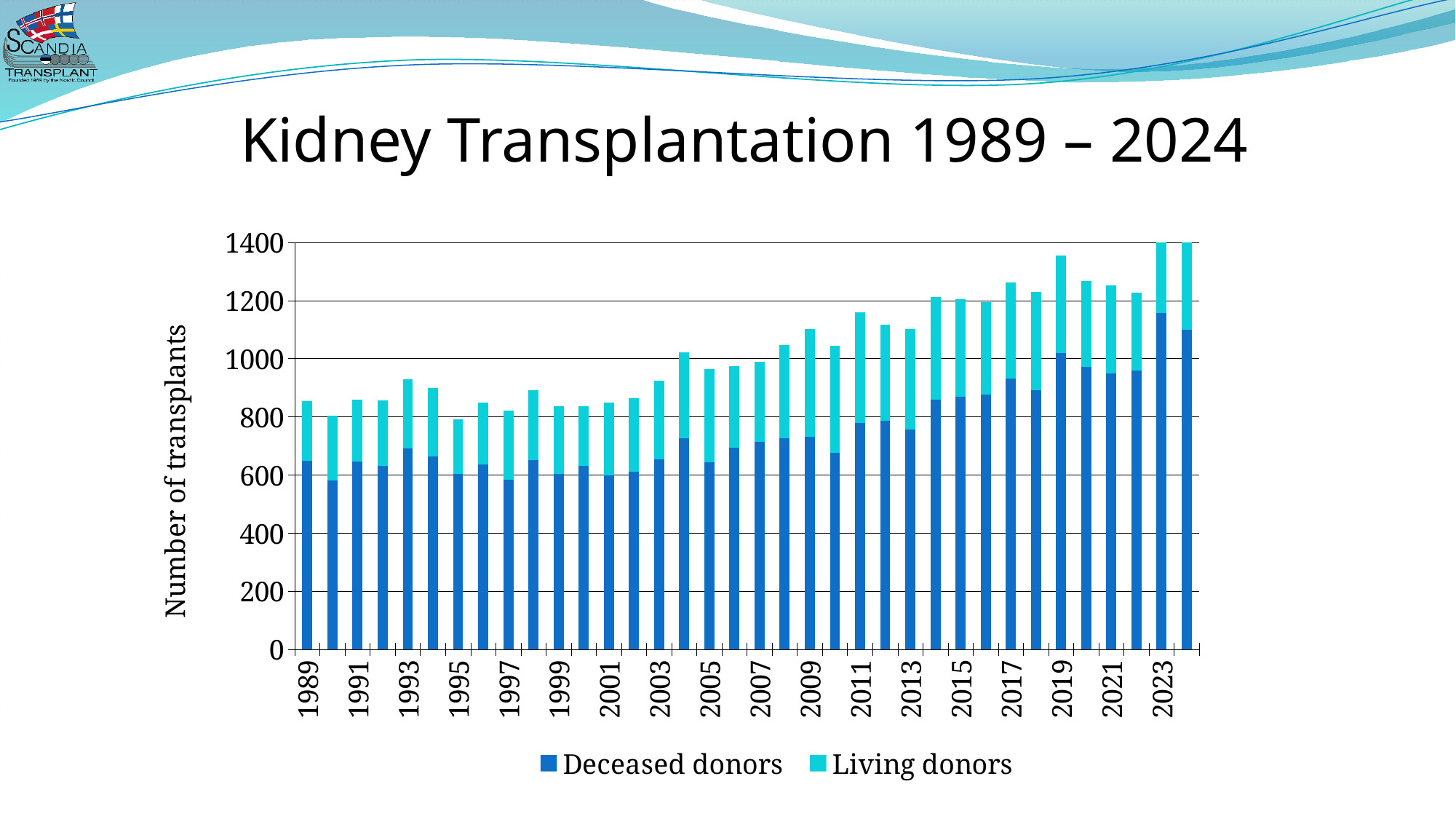
Is the number of transplants from deceased donors in 2023 greater or less than 1000? greater What is the label on the vertical axis? Number of transplants How many series does the legend list? 2 Is the number of transplants from deceased donors in 1989 greater or less than 600? greater Is the total number of transplants in 1990 greater or less than 1000? less How many years (bars) are plotted in the chart? 36 Overall, do total kidney transplants rise or fall from 1989 to 2024? rise Which year has the larger total number of transplants, 2018 or 2019? 2019 What kind of chart is shown on the slide? Stacked bar chart What is the title of the chart on the slide? Kidney Transplantation 1989 – 2024